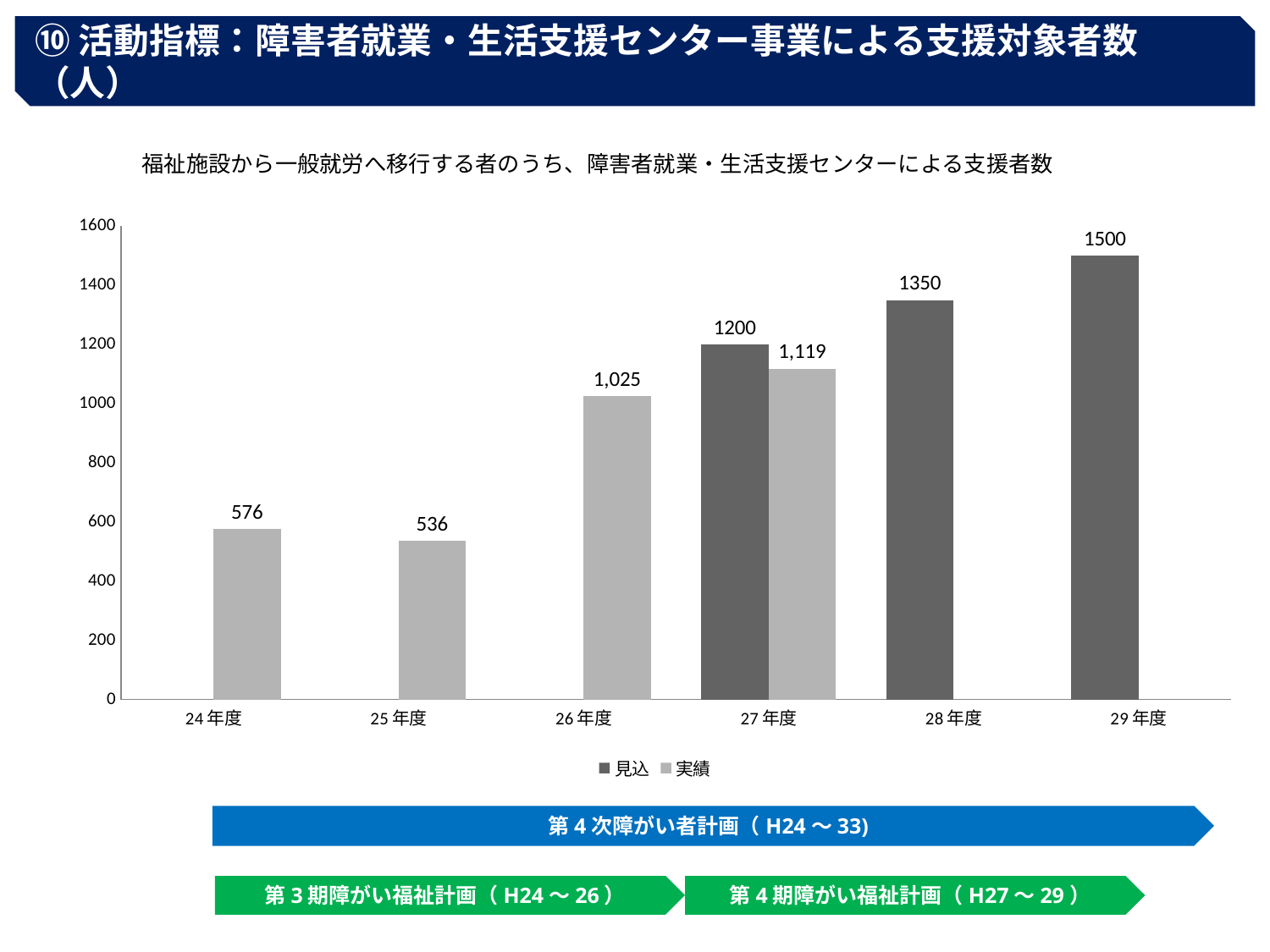
Which is larger, the 実績 value for 24年度 or for 25年度? 24年度 What is the 見込 (forecast) value for 27年度? 1200 How many fiscal years are shown on the x axis? 6 Which fiscal year has the lowest 実績 (actual) value? 25年度 What is the difference between the 見込 and 実績 values for 27年度? 81 What is the 実績 (actual) value for 26年度? 1,025 What kind of chart is shown on the slide? Bar chart What is the 実績 (actual) value for 24年度? 576 How many series does the legend list? 2 What is the 見込 (forecast) value for 29年度? 1500 Do the 見込 (forecast) values rise or fall from 27年度 to 29年度? Rise Which fiscal year has the highest 見込 (forecast) value? 29年度